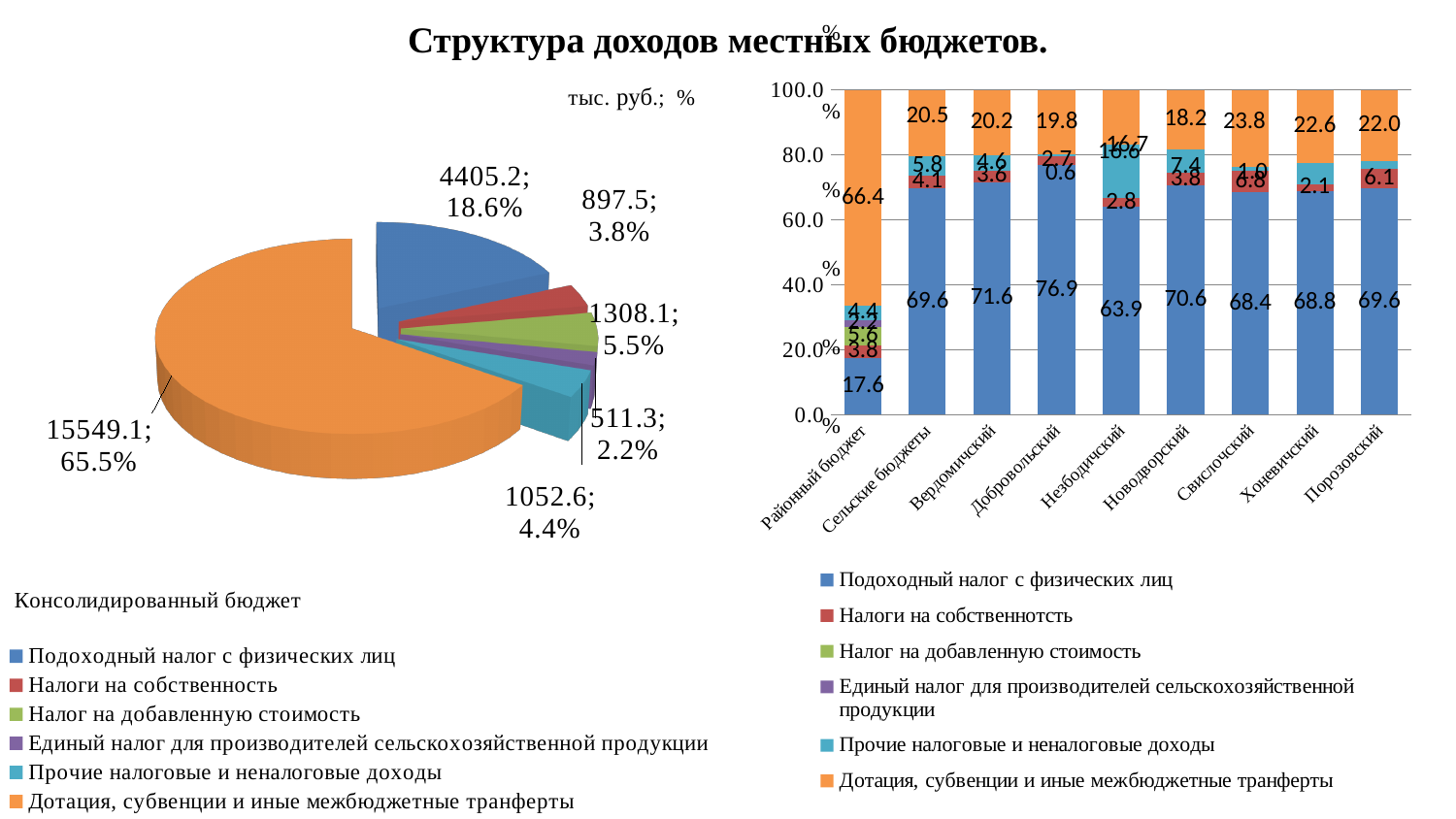
What kind of chart is the left chart (Консолидированный бюджет)? pie chart In the left pie chart, what value is shown for 'Подоходный налог с физических лиц'? 4405.2; 18.6% What kind of chart is the right chart? bar chart In the left pie chart, what share does 'Дотация, субвенции и иные межбюджетные транферты' have? 65.5% In the right bar chart, what is the value of 'Подоходный налог с физических лиц' for Добровольский? 76.9 How many series does the legend of the right bar chart list? 6 In the right bar chart, which category has the lowest value for 'Подоходный налог с физических лиц'? Районный бюджет In the left pie chart, which category has the smallest slice? Единый налог для производителей сельскохозяйственной продукции How many slices does the left pie chart have? 6 In the right bar chart, what is the difference in 'Подоходный налог с физических лиц' between Вердомичский and Сельские бюджеты? 2.0 In the right bar chart, what is the value of 'Дотация, субвенции и иные межбюджетные транферты' for Районный бюджет? 66.4 How many categories are shown on the x axis of the right bar chart? 9